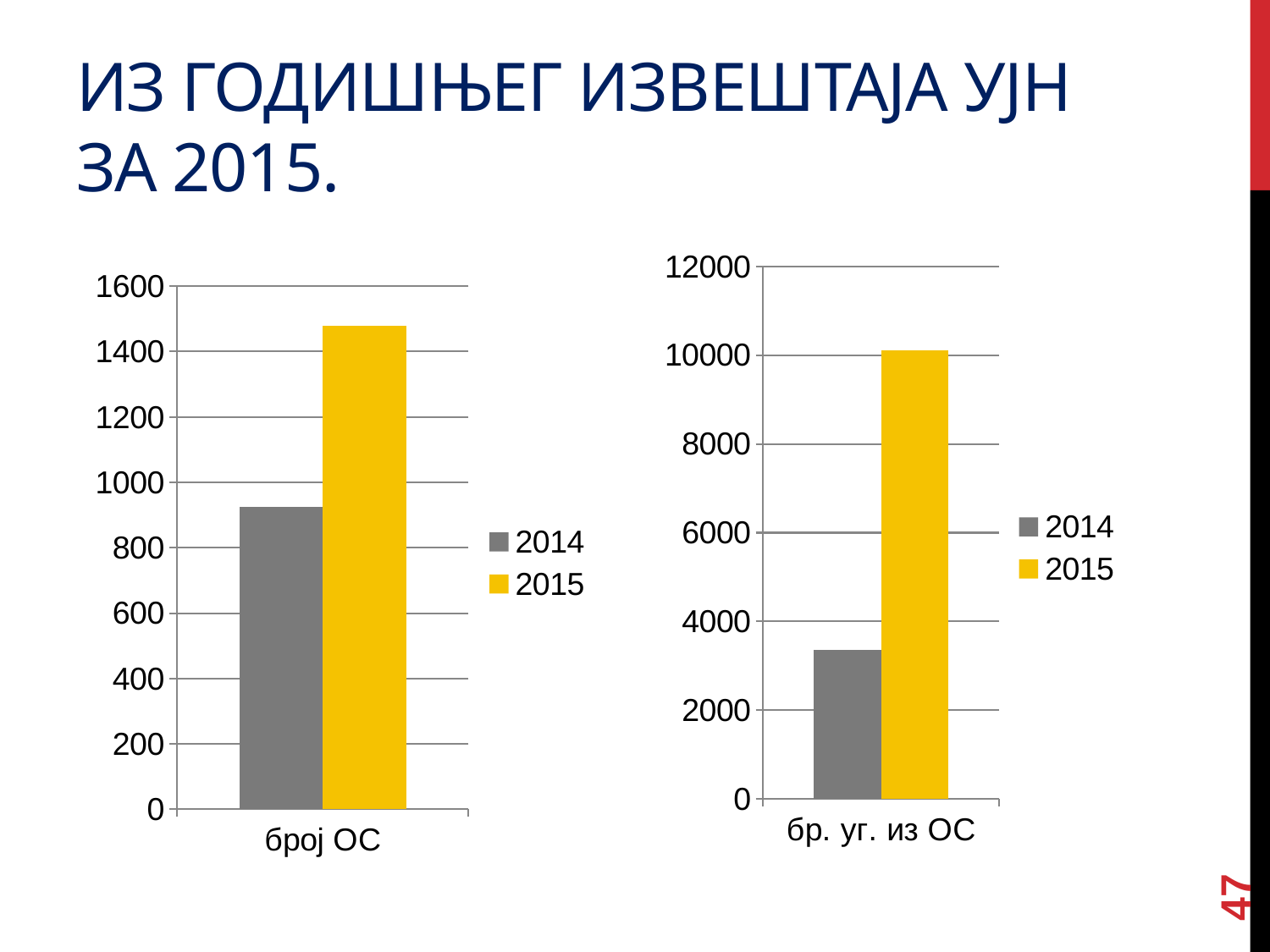
In the left chart (број ОС), is the value for 2015 greater or less than 1400? greater In the right chart (бр. уг. из ОС), is the value for 2015 greater or less than 8000? greater How many series does the legend of the right chart (бр. уг. из ОС) list? 2 In the left chart (број ОС), is the value for 2014 greater or less than 1000? less In the left chart (број ОС), what colour is the bar for the 2015 series? yellow How many categories are shown on the x axis of the right chart (бр. уг. из ОС)? 1 In the left chart (број ОС), which series has the taller bar, 2014 or 2015? 2015 In the right chart (бр. уг. из ОС), which series has the taller bar, 2014 or 2015? 2015 What kind of chart is the right chart (бр. уг. из ОС)? bar chart How many series does the legend of the left chart (број ОС) list? 2 What kind of chart is the left chart (број ОС)? bar chart